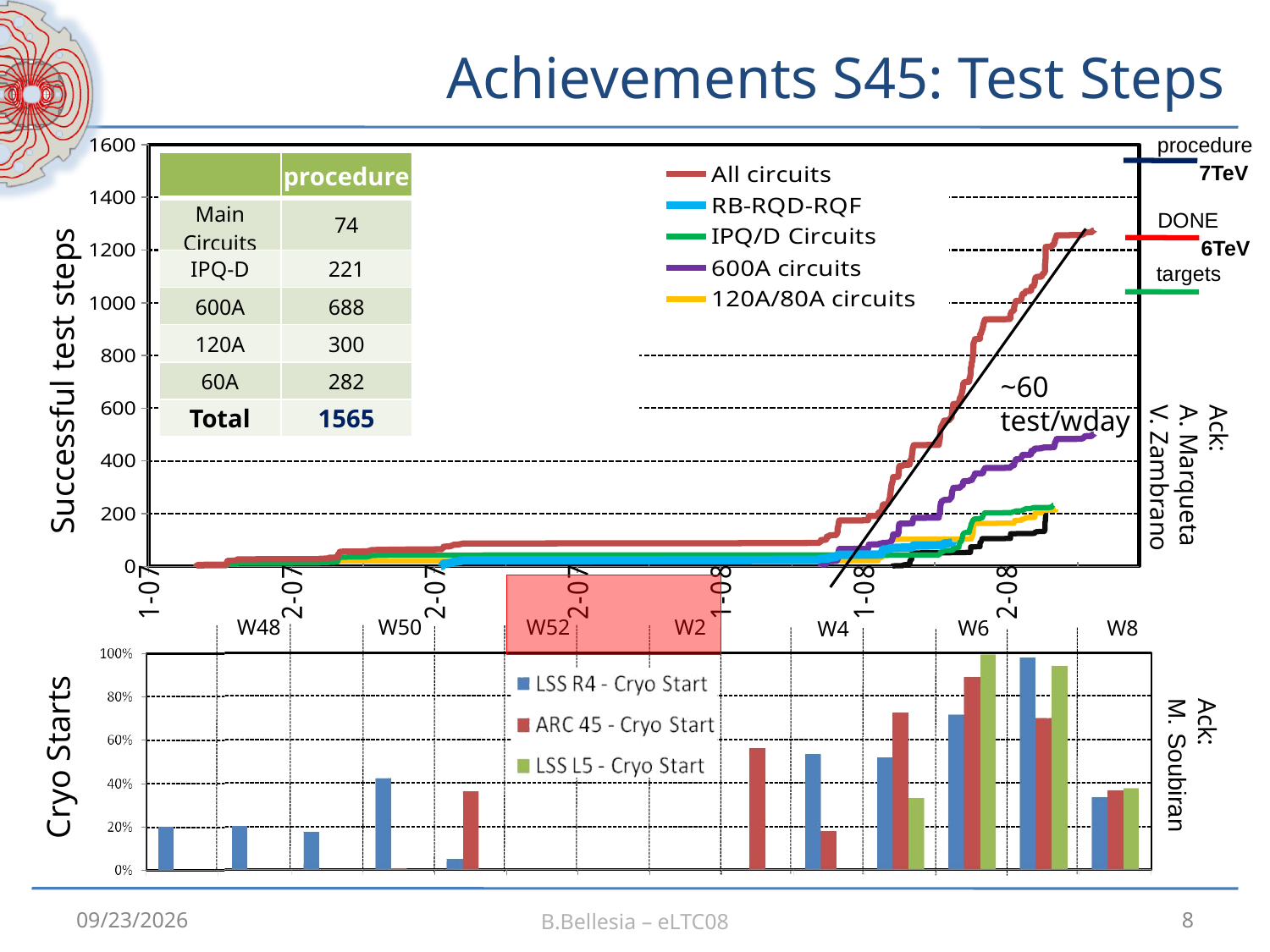
What kind of chart is the top chart (Successful test steps)? line chart In the top chart (Successful test steps), which line ends higher at the right edge: All circuits or 600A circuits? All circuits In the bottom chart (Cryo Starts), is the tallest LSS R4 - Cryo Start bar greater or less than 80%? greater What is the y-axis label of the top chart? Successful test steps In the top chart (Successful test steps), is the final value of the All circuits line greater or less than 1200? greater In the top chart, which series is drawn in red according to the legend? All circuits How many series does the legend of the bottom chart (Cryo Starts) list? 3 In the top chart (Successful test steps), is the final value of the 600A circuits line greater or less than 400? greater In the top chart (Successful test steps), does the All circuits line rise or fall along the x axis? rise What kind of chart is the bottom chart (Cryo Starts)? bar chart How many series does the legend of the top chart (Successful test steps) list? 5